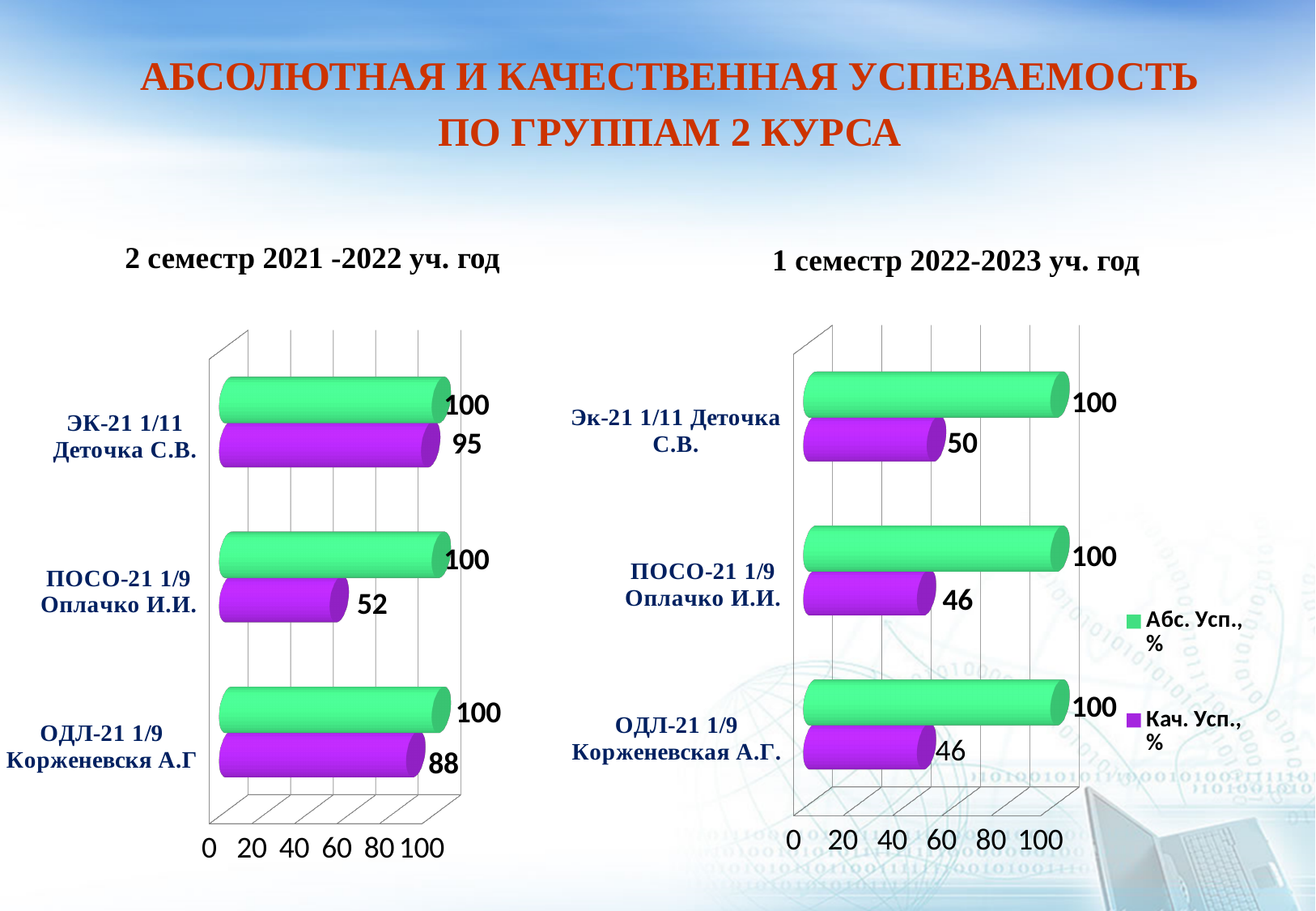
In the chart titled "2 семестр 2021 -2022 уч. год", which group has the lowest Кач. Усп., % value? ПОСО-21 1/9 Оплачко И.И. In the chart titled "1 семестр 2022-2023 уч. год", what is the difference between the Кач. Усп., % values for Эк-21 1/11 Деточка С.В. and ПОСО-21 1/9 Оплачко И.И.? 4 How many series does the legend on the slide list? 2 In the chart titled "2 семестр 2021 -2022 уч. год", what is the difference between the Абс. Усп., % and Кач. Усп., % values for ОДЛ-21 1/9 Корженевская А.Г? 12 In the chart titled "1 семестр 2022-2023 уч. год", what is the Кач. Усп., % value for Эк-21 1/11 Деточка С.В.? 50 Which is larger: the Кач. Усп., % value for ОДЛ-21 1/9 Корженевская in the "2 семестр 2021 -2022 уч. год" chart or in the "1 семестр 2022-2023 уч. год" chart? 2 семестр 2021 -2022 уч. год How many groups are shown in the chart titled "1 семестр 2022-2023 уч. год"? 3 In the chart titled "1 семестр 2022-2023 уч. год", which group has the highest Кач. Усп., % value? Эк-21 1/11 Деточка С.В. In the chart titled "2 семестр 2021 -2022 уч. год", what is the Кач. Усп., % value for ПОСО-21 1/9 Оплачко И.И.? 52 What type of chart is the chart titled "2 семестр 2021 -2022 уч. год"? Bar chart In the chart titled "1 семестр 2022-2023 уч. год", what is the Абс. Усп., % value for ОДЛ-21 1/9 Корженевская А.Г.? 100 In the chart titled "2 семестр 2021 -2022 уч. год", what is the Кач. Усп., % value for ЭК-21 1/11 Деточка С.В.? 95